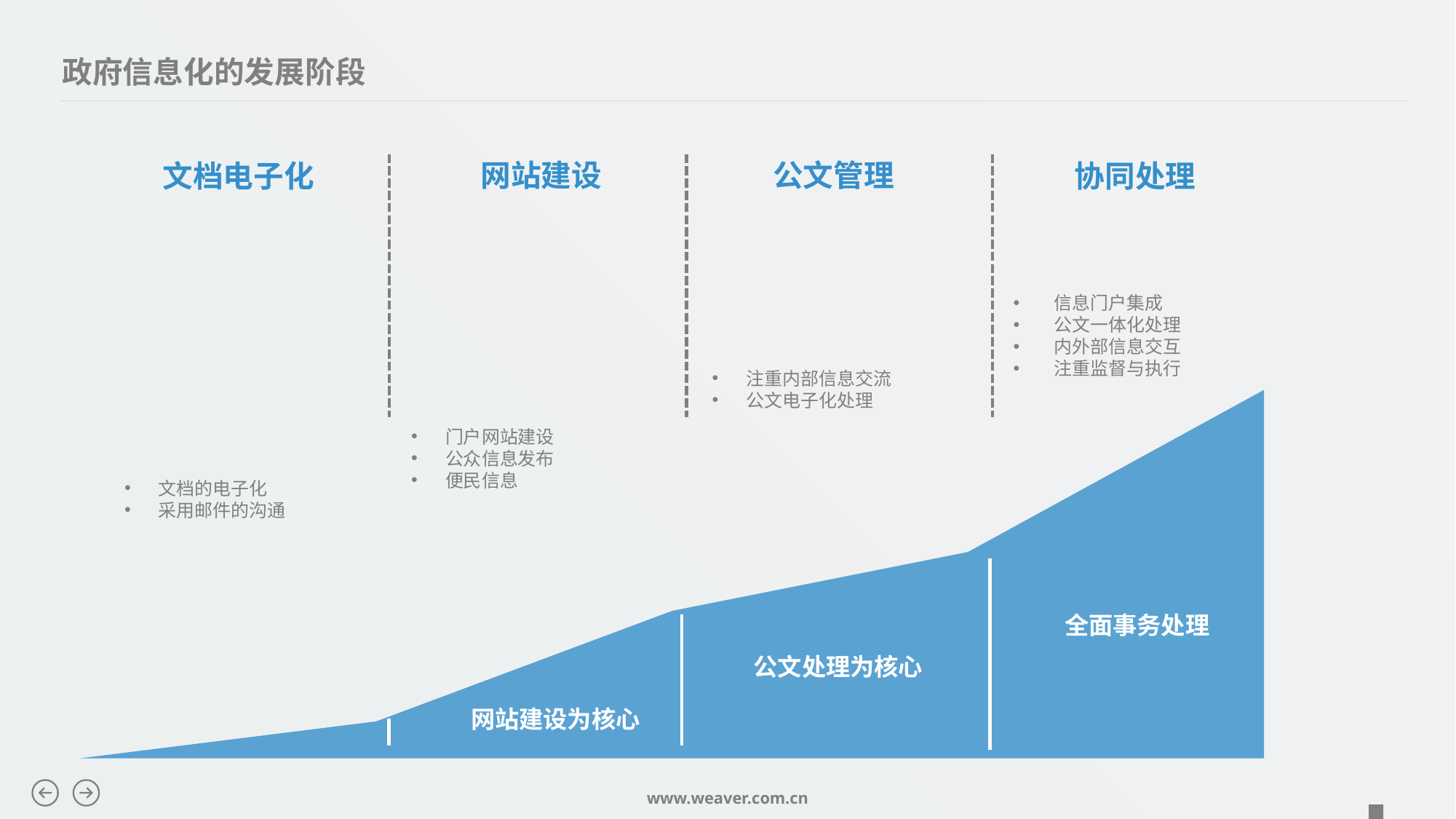
Does the blue area rise or fall from left to right across the slide? rise What is the title of the slide? 政府信息化的发展阶段 What kind of chart is shown on the slide? area chart How many development stages are shown along the chart? 4 Is the blue area higher at the 公文管理 stage or at the 网站建设 stage? 公文管理 Which stage is shown at the lowest point of the blue area? 文档电子化 Which stage is shown at the highest point of the blue area? 协同处理 What label is printed inside the blue area under the 协同处理 stage? 全面事务处理